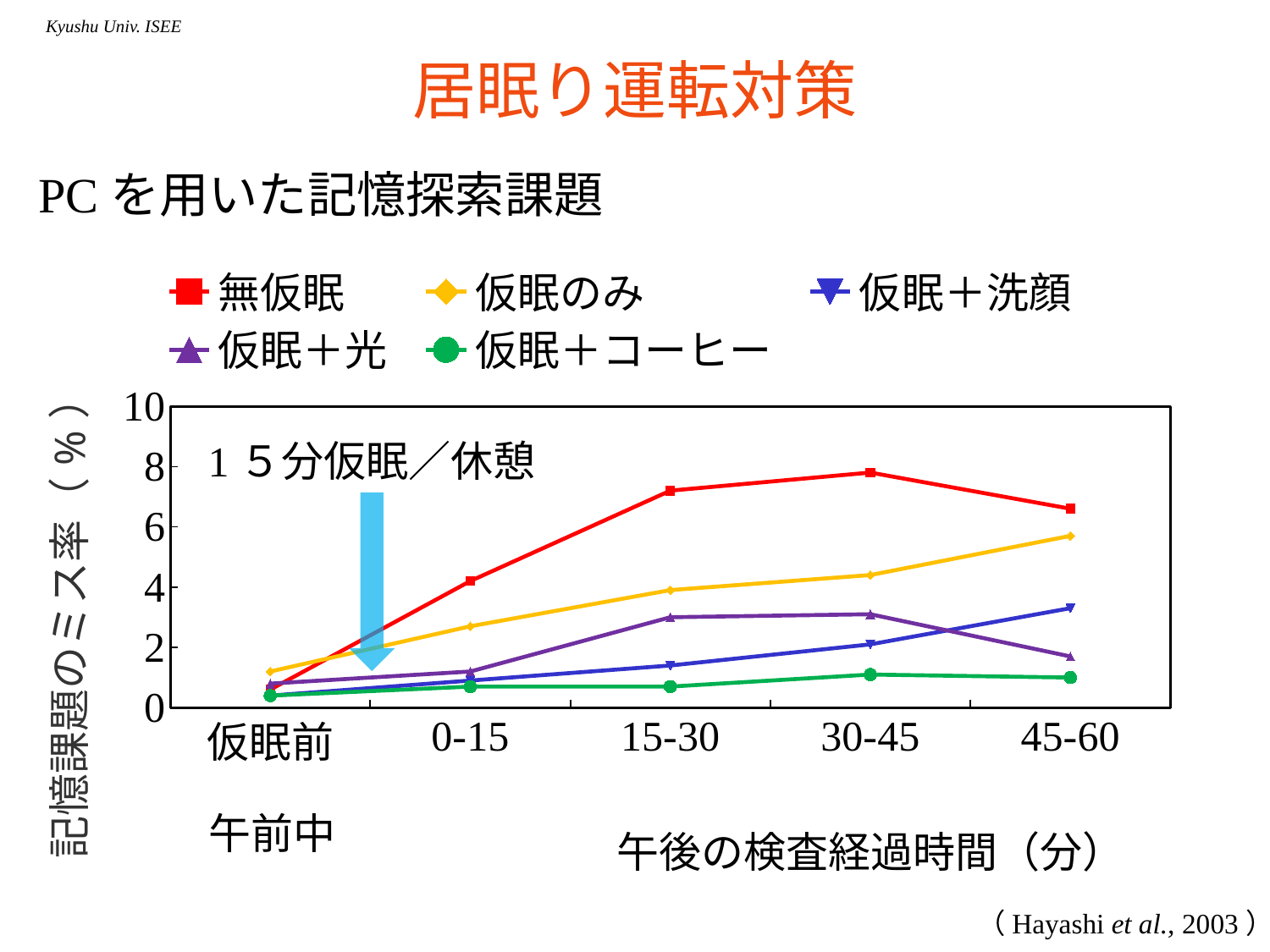
Which series has the highest value at 30-45? 無仮眠 Which colour is used for the 無仮眠 series? red Which series has the lowest value at 45-60? 仮眠＋コーヒー How many series does the legend list? 5 Is the value for 仮眠＋コーヒー at 45-60 greater or less than 2? less How many categories are shown along the x axis? 5 At 45-60, which is larger: 仮眠＋洗顔 or 仮眠＋光? 仮眠＋洗顔 Is the value for 無仮眠 at 30-45 greater or less than 6? greater What is the label of the y axis? 記憶課題のミス率（%） Does the 仮眠のみ series rise or fall from 仮眠前 to 45-60? rise What kind of chart is shown on the slide? line chart Is the value for 仮眠のみ at 45-60 greater or less than 4? greater